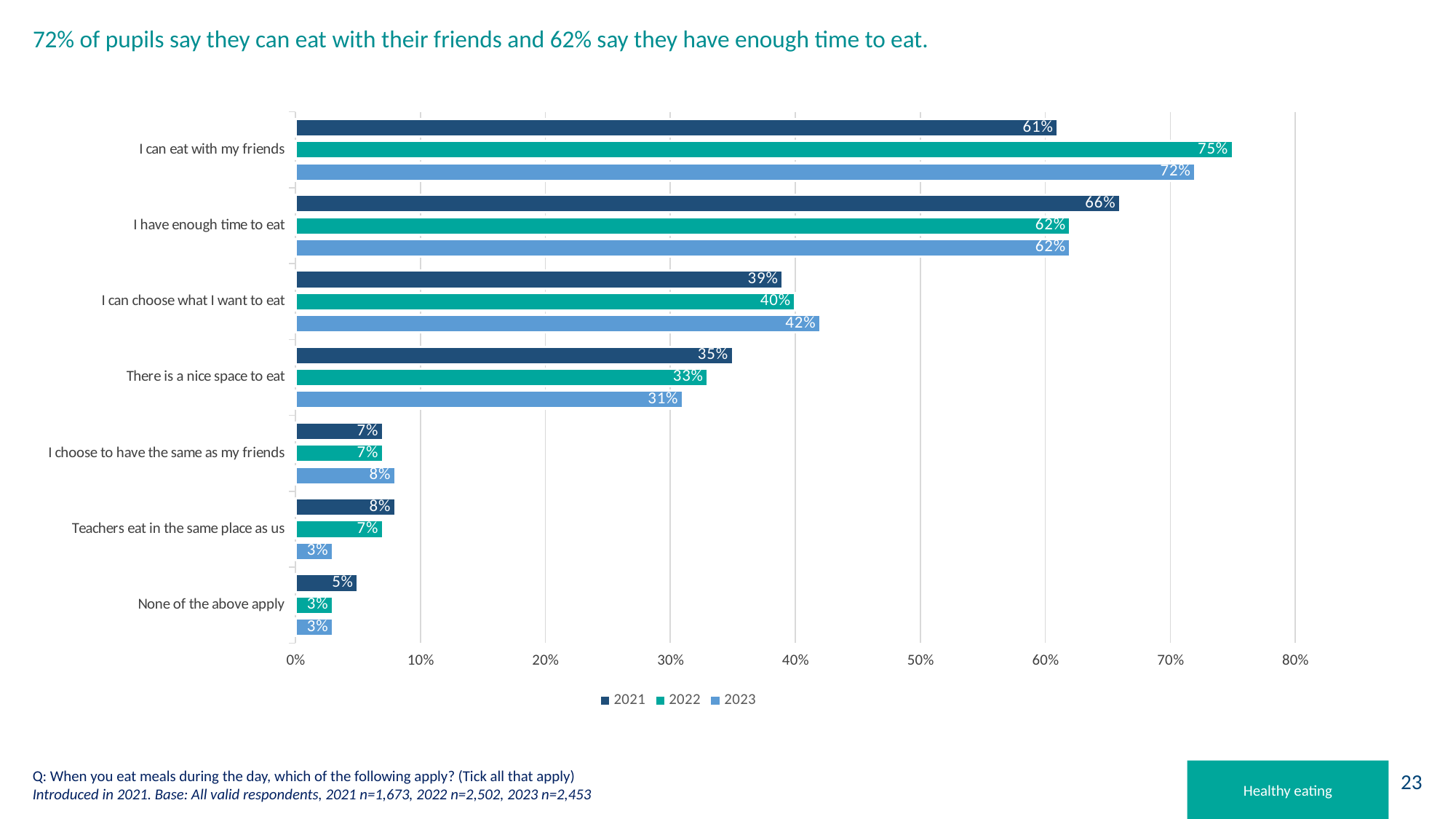
How many series does the legend list? 3 Which is larger for 'There is a nice space to eat': the 2021 value or the 2023 value? 2021 How many categories are shown on the chart? 7 Which year does the light blue series in the legend represent? 2023 What was the value for 'I have enough time to eat' in 2021? 66% Which category had the lowest value in 2021? None of the above apply What percentage said 'Teachers eat in the same place as us' in 2023? 3% What percentage of pupils said 'I can eat with my friends' in 2023? 72% What is the difference between the 2022 and 2021 values for 'I can eat with my friends'? 14 percentage points Did the value for 'I can choose what I want to eat' rise or fall from 2021 to 2023? Rise Which category had the highest value in 2022? I can eat with my friends What type of chart is shown on the slide? Bar chart